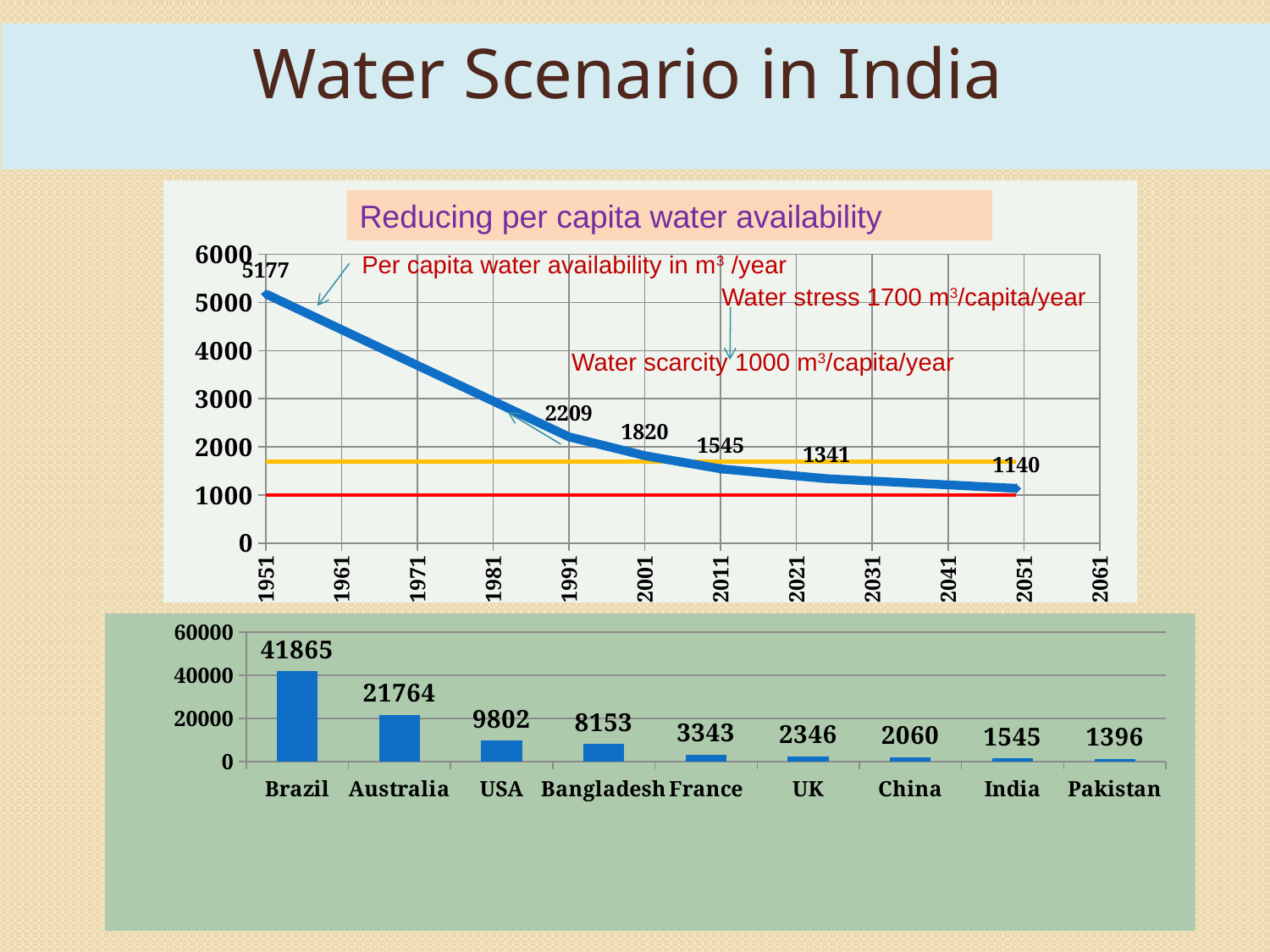
In the bottom bar chart, which is larger, the value for China or the value for UK? UK How many countries are shown in the bottom bar chart? 9 In the bottom bar chart, which country has the highest value? Brazil In the bottom bar chart, which country has the lowest value? Pakistan In the bottom bar chart, what is the value for India? 1545 In the top chart, what water availability level is labelled as water scarcity? 1000 m³/capita/year In the top chart 'Reducing per capita water availability', what is the per capita water availability value labelled at 1951? 5177 In the top chart 'Reducing per capita water availability', what is the per capita water availability value labelled at 2051? 1140 What type of chart is the bottom chart on the slide? bar chart In the top chart 'Reducing per capita water availability', does per capita water availability rise or fall over time? fall In the bottom bar chart, what is the difference between the values for Australia and USA? 11962 In the bottom bar chart, what is the value for Brazil? 41865